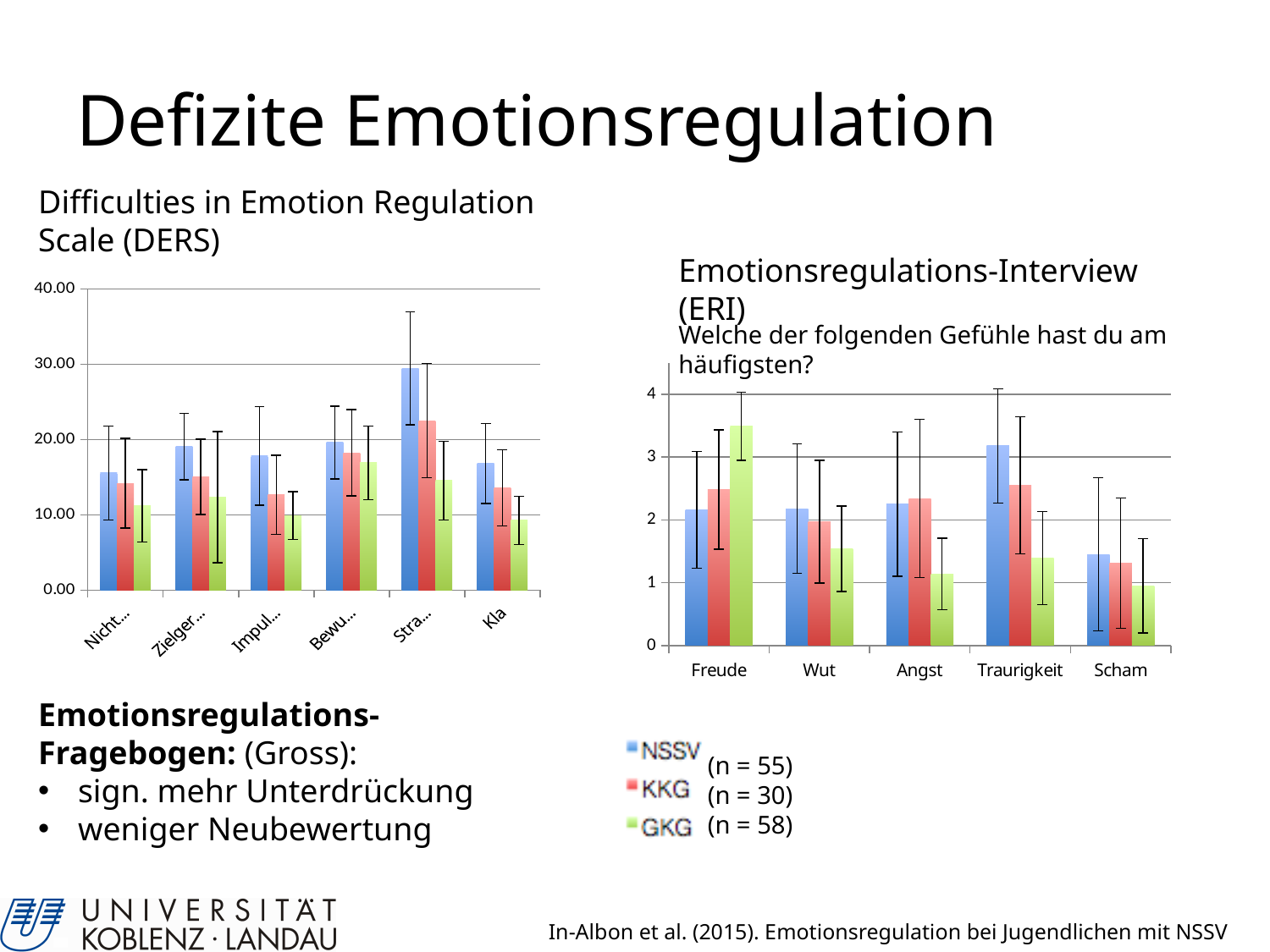
How many series does the legend list for the charts? 3 In the Emotionsregulations-Interview (ERI) chart, is the GKG value for Freude greater or less than 3? greater In the Emotionsregulations-Interview (ERI) chart, is the NSSV value for Traurigkeit greater or less than 3? greater In the Emotionsregulations-Interview (ERI) chart, for Freude, which is larger: the GKG bar or the NSSV bar? GKG In the Emotionsregulations-Interview (ERI) chart, is the GKG value for Angst greater or less than 2? less How many categories are shown on the x axis of the Emotionsregulations-Interview (ERI) chart? 5 In the Emotionsregulations-Interview (ERI) chart, which category has the lowest NSSV bar? Scham In the Emotionsregulations-Interview (ERI) chart, which category has the highest GKG bar? Freude How many categories are shown on the x axis of the Difficulties in Emotion Regulation Scale (DERS) chart? 6 What kind of chart is the Emotionsregulations-Interview (ERI) chart on the right? bar chart In the Emotionsregulations-Interview (ERI) chart, which category has the highest NSSV bar? Traurigkeit